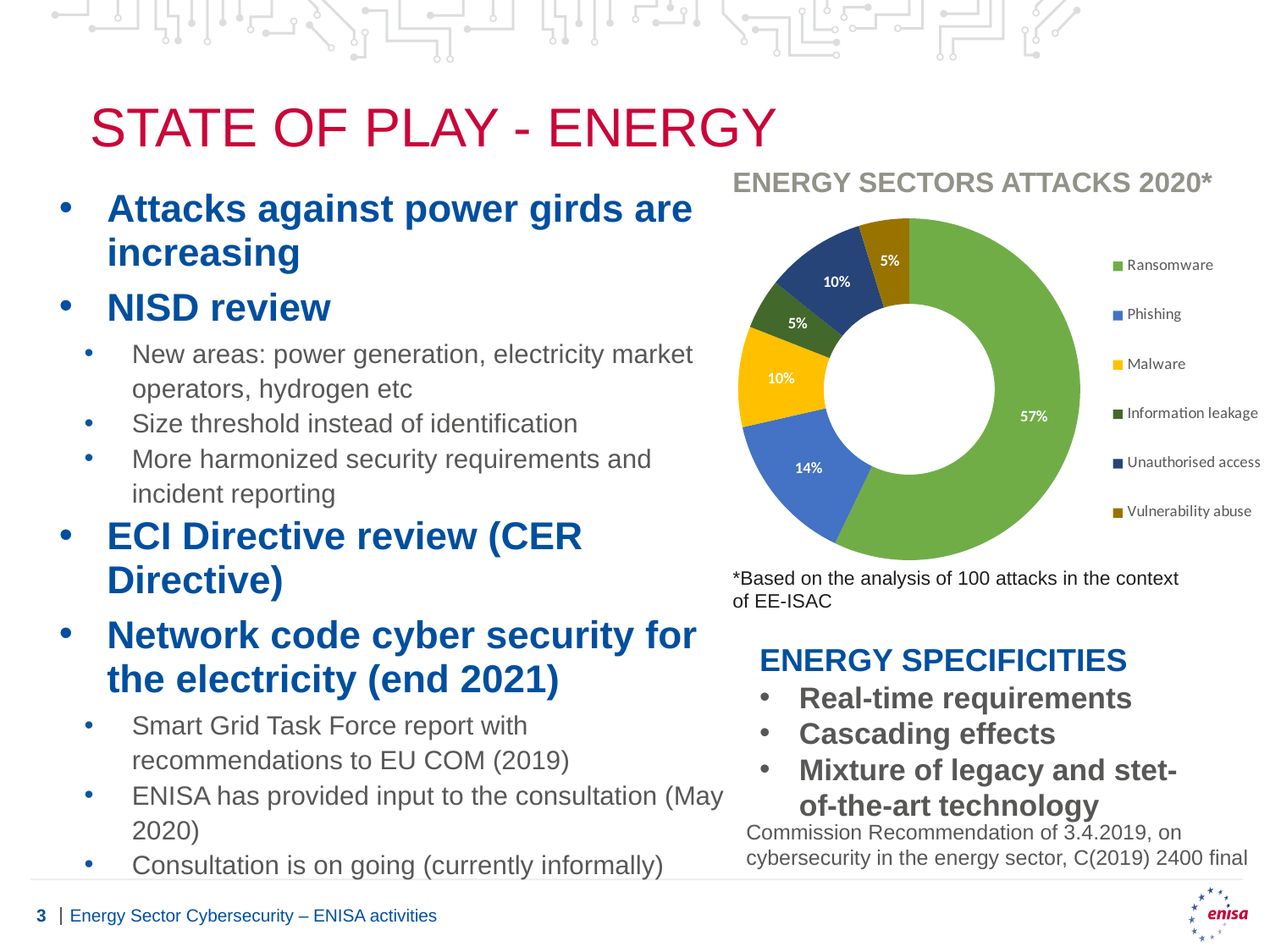
Which attack type accounts for the largest share of the pie chart? Ransomware What percentage of attacks is shown for information leakage? 5% What percentage of attacks is shown for malware? 10% How many attack categories does the legend of the pie chart list? 6 Which is larger, the share for phishing or the share for malware? Phishing What type of chart is shown under the title "ENERGY SECTORS ATTACKS 2020*"? Doughnut chart What is the combined share of malware and unauthorised access? 20% What percentage of attacks is shown for unauthorised access? 10% What percentage of energy sector attacks in 2020 were ransomware? 57% What share of the pie chart is attributed to phishing? 14% What is the difference in percentage points between ransomware and phishing? 43 According to the footnote, how many attacks was the pie chart analysis based on? 100